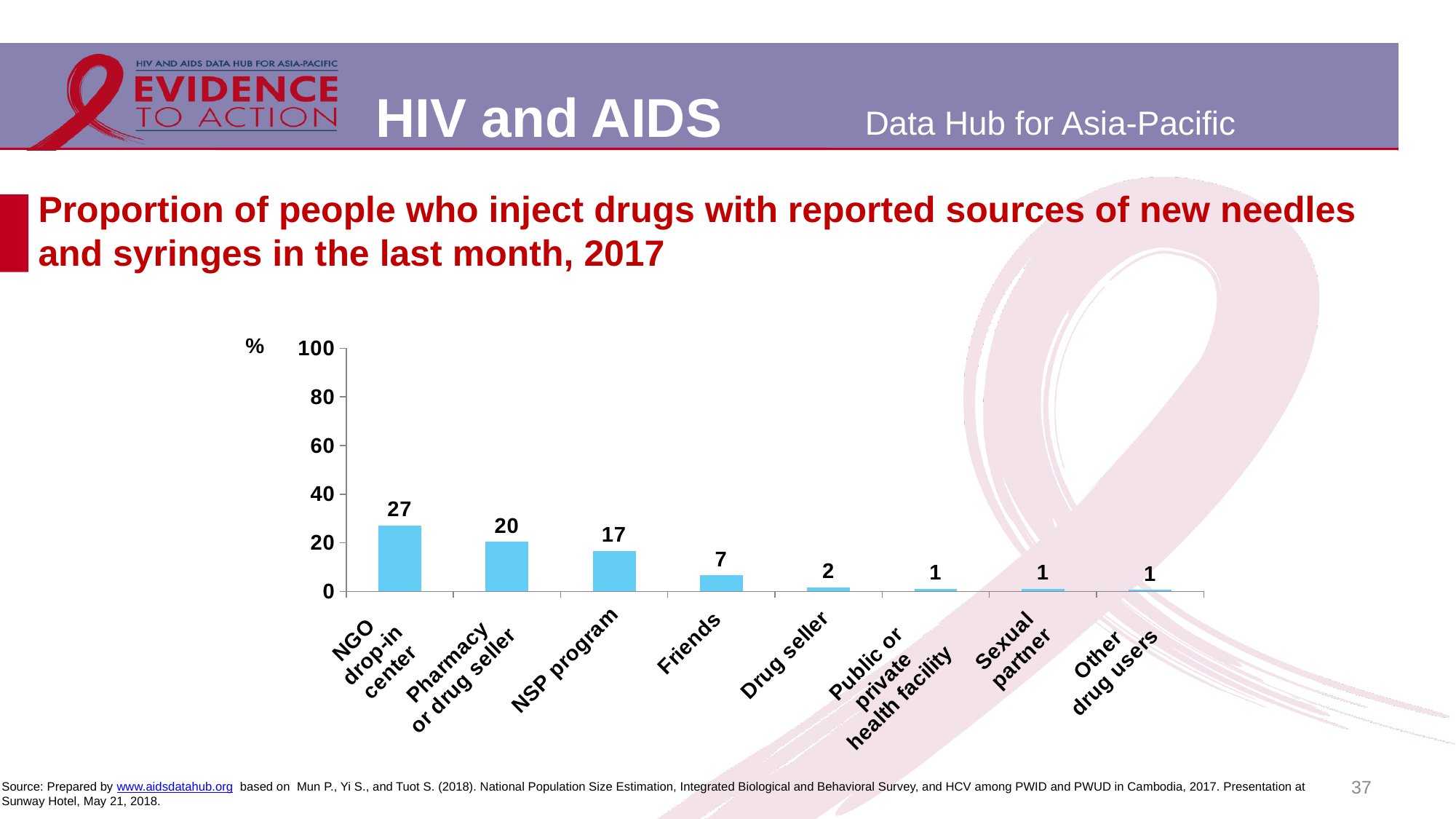
What is the value for Pharmacy or drug seller? 20 What is the value for Friends? 7 What kind of chart is shown on the slide? bar chart What is the value for NSP program? 17 Which source has the highest value? NGO drop-in center What is the value for NGO drop-in center? 27 Is the value for NGO drop-in center greater or less than 40? less Which is larger, the value for Pharmacy or drug seller or the value for Friends? Pharmacy or drug seller How many sources are shown on the x axis? 8 What unit is shown on the y axis of the chart? % What is the difference between the values for NGO drop-in center and NSP program? 10 What is the value for Drug seller? 2